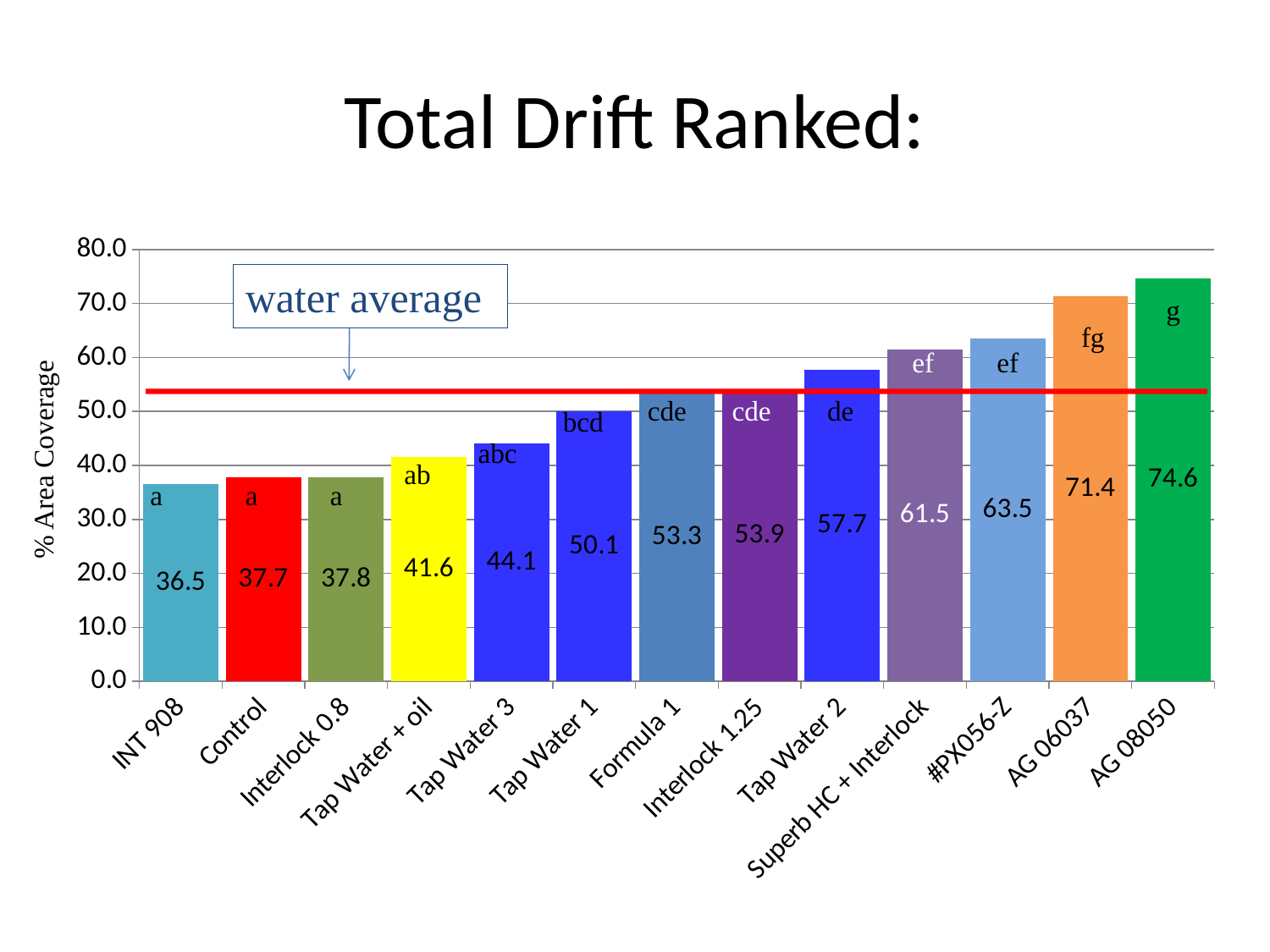
What is the % Area Coverage value for Tap Water 1? 50.1 What is the difference in % Area Coverage between Tap Water 2 and Tap Water 3? 13.6 What is the % Area Coverage value for Control? 37.7 Is the value for #PX056-Z greater or less than 60.0? greater What is the % Area Coverage value for AG 06037? 71.4 Which category has the lowest % Area Coverage? INT 908 What is the difference in % Area Coverage between AG 08050 and INT 908? 38.1 What kind of chart is shown on the slide? bar chart What does the red horizontal line on the chart represent? water average Which has a higher % Area Coverage, Formula 1 or Tap Water + oil? Formula 1 How many categories are shown on the x axis? 13 Which category has the highest % Area Coverage? AG 08050